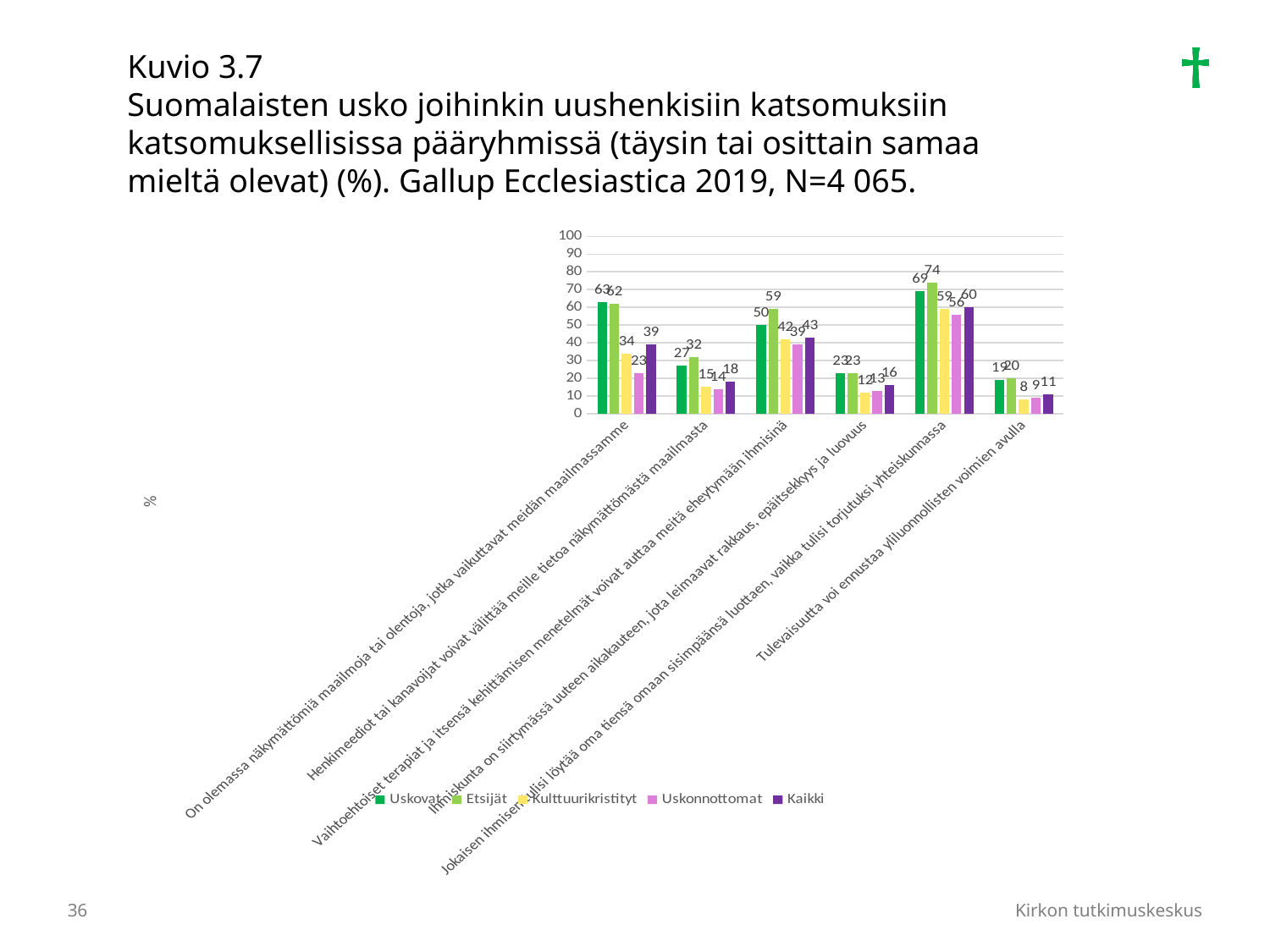
Which statement has the lowest value for Kulttuurikristityt? Tulevaisuutta voi ennustaa yliluonnollisten voimien avulla What is the difference between Uskovat and Uskonnottomat for the statement 'On olemassa näkymättömiä maailmoja tai olentoja, jotka vaikuttavat meidän maailmassamme'? 40 For the statement 'Vaihtoehtoiset terapiat ja itsensä kehittämisen menetelmät voivat auttaa meitä eheytymään ihmisinä', which is larger: Uskovat or Etsijät? Etsijät Is the value for Kaikki for the statement 'Vaihtoehtoiset terapiat ja itsensä kehittämisen menetelmät voivat auttaa meitä eheytymään ihmisinä' greater or less than 50? less How many series does the legend list? 5 What kind of chart is shown on the slide? bar chart How many statement categories are shown on the x axis? 6 What is the value for Uskonnottomat for the statement 'Henkimeediot tai kanavoijat voivat välittää meille tietoa näkymättömästä maailmasta'? 14 What is the value for Kaikki for the statement 'Tulevaisuutta voi ennustaa yliluonnollisten voimien avulla'? 11 What is the value for Etsijät for the statement 'Jokaisen ihmisen tulisi löytää oma tiensä omaan sisimpäänsä luottaen, vaikka tulisi torjutuksi yhteiskunnassa'? 74 Which statement has the highest value for Kaikki? Jokaisen ihmisen tulisi löytää oma tiensä omaan sisimpäänsä luottaen, vaikka tulisi torjutuksi yhteiskunnassa Which series is shown in purple in the legend? Kaikki